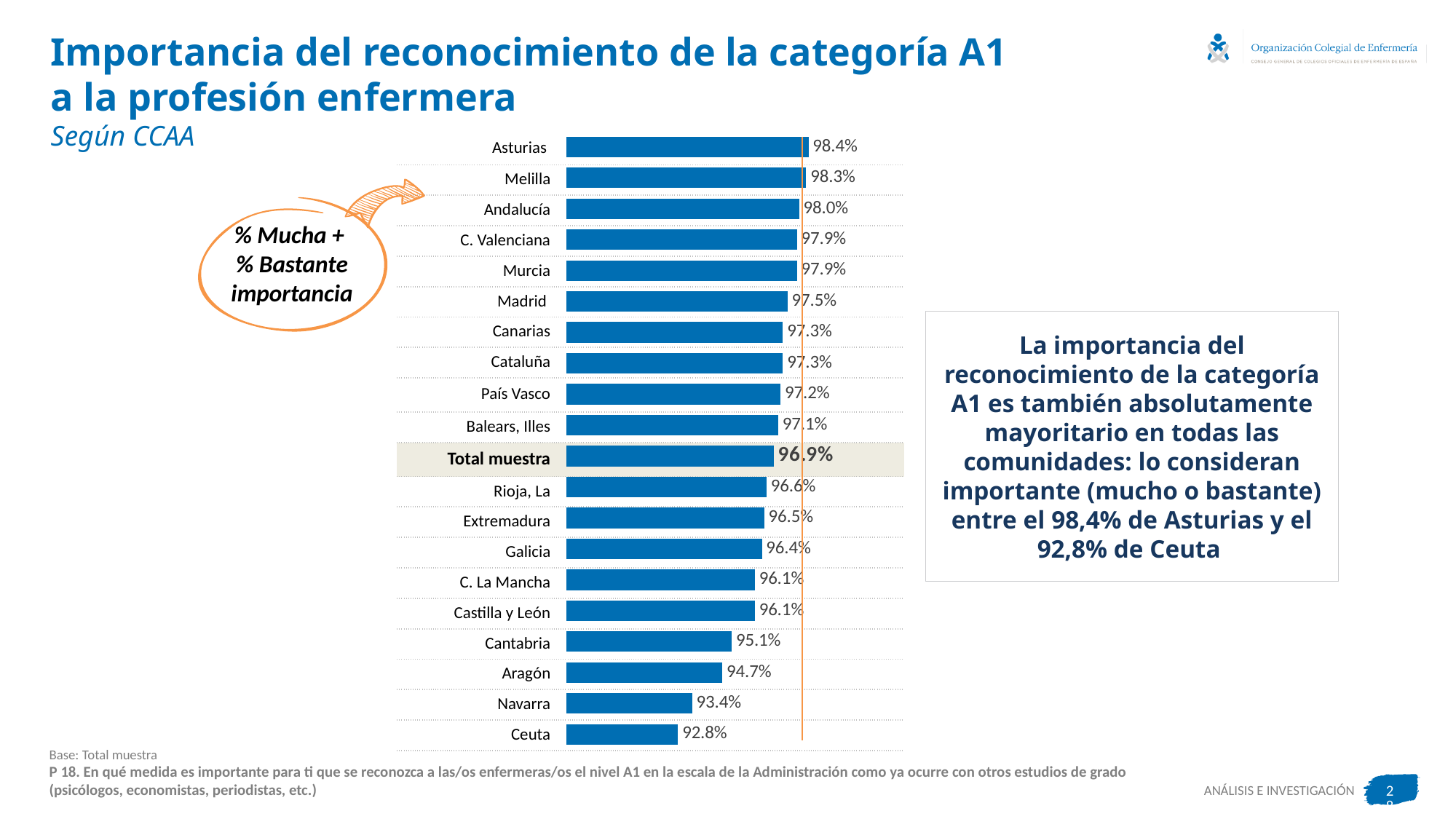
What does the orange callout say the bars represent? % Mucha + % Bastante importancia What is the value for Asturias? 98.4% Which has a larger value, Aragón or Cantabria? Cantabria What is the difference between the values for Asturias and Ceuta? 5.6% Which category has the highest value? Asturias What is the value for Navarra? 93.4% Which category has the lowest value? Ceuta What is the difference between the values for Madrid and Cantabria? 2.4% How many categories (bars) are shown in the chart? 20 What kind of chart is shown on the slide? Bar chart Which has a larger value, Galicia or Melilla? Melilla What is the value for Total muestra? 96.9%